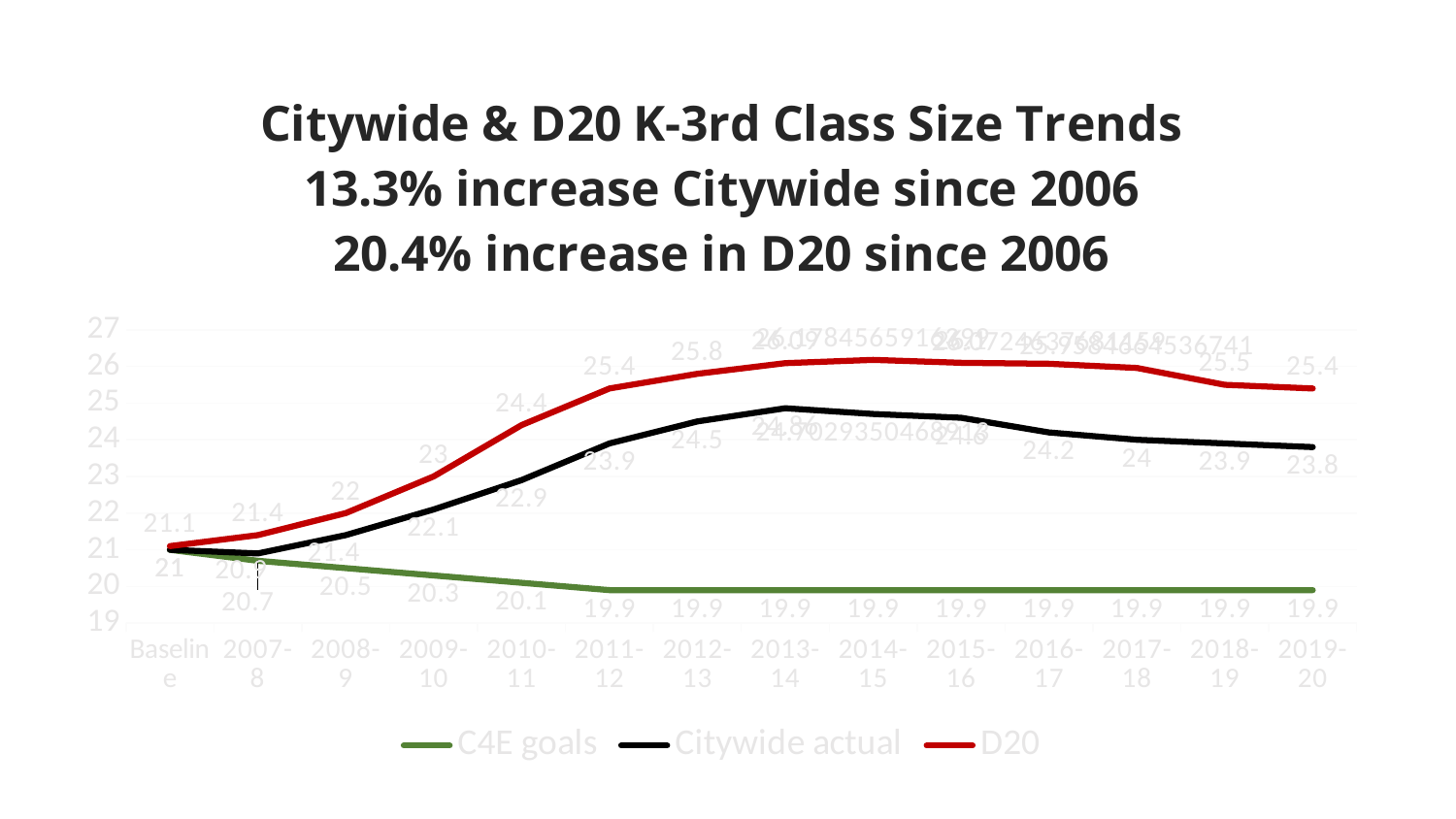
How many series does the legend list? 3 Which series is drawn in red? D20 Does the C4E goals line rise or fall from Baseline to 2011-12? fall What is the C4E goals value for 2010-11? 20.1 Which is larger in 2011-12, the D20 value or the Citywide actual value? D20 How many categories are shown along the x axis? 14 What is the D20 value for 2012-13? 25.8 What kind of chart is shown on the slide? line chart Is the Citywide actual value for 2013-14 greater or less than 24? greater What is the difference between the D20 value and the Citywide actual value in 2019-20? 1.6 What is the D20 value for 2009-10? 23 What is the Citywide actual value for 2019-20? 23.8